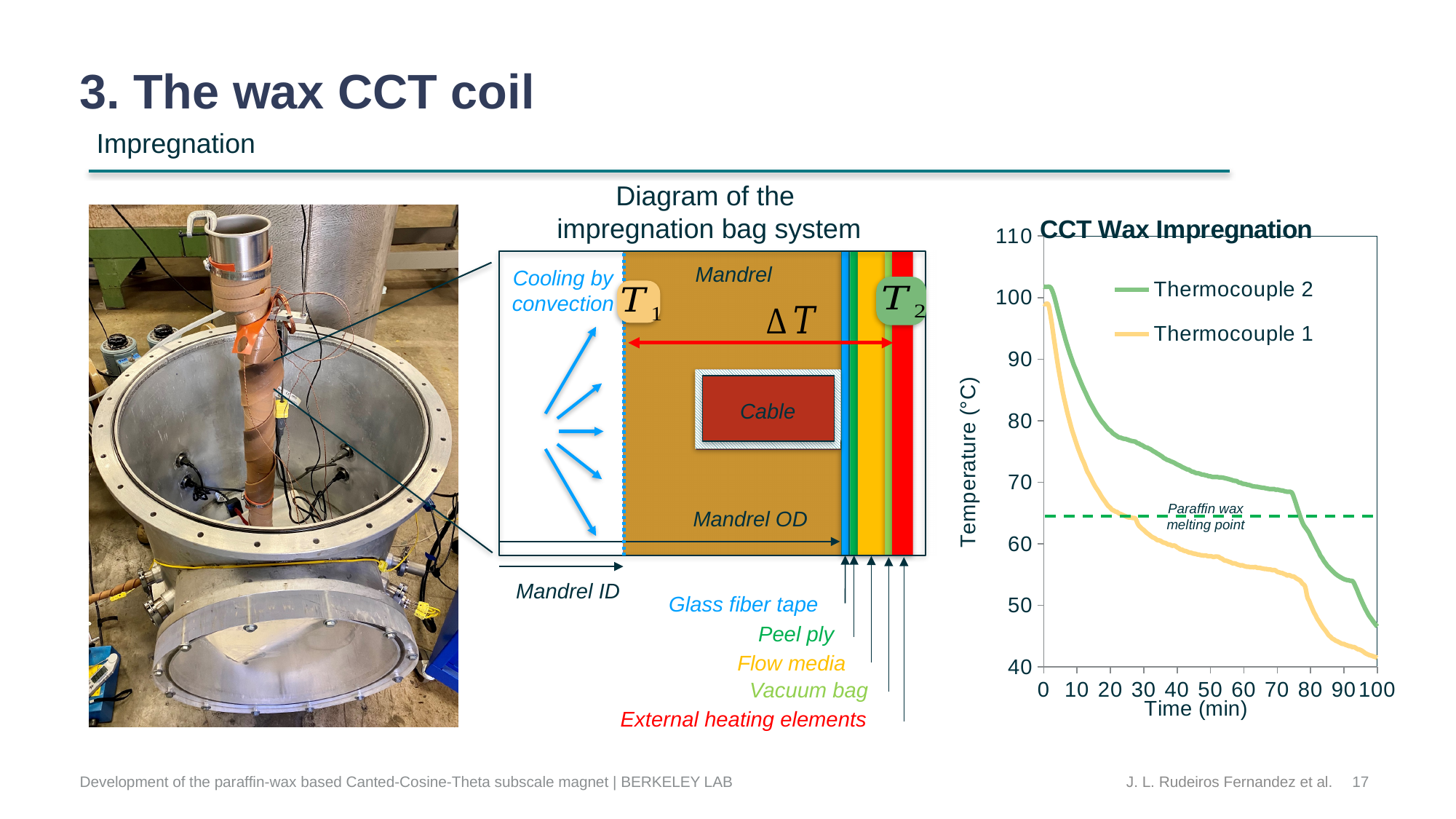
What kind of chart is the "CCT Wax Impregnation" chart? line chart In the "CCT Wax Impregnation" chart, does the temperature for Thermocouple 2 rise or fall as time increases? fall In the "CCT Wax Impregnation" chart, is the value for Thermocouple 2 at 20 min greater or less than 70? greater In the "CCT Wax Impregnation" chart, is the value for Thermocouple 1 at 50 min greater or less than 60? less In the "CCT Wax Impregnation" chart, which series has the higher temperature at 50 min, Thermocouple 1 or Thermocouple 2? Thermocouple 2 What is the label of the y axis of the "CCT Wax Impregnation" chart? Temperature (°C) In the "CCT Wax Impregnation" chart, does the temperature for Thermocouple 1 rise or fall over time? fall What does the dashed horizontal line in the "CCT Wax Impregnation" chart represent? Paraffin wax melting point In the "CCT Wax Impregnation" chart, is the value for Thermocouple 1 at 20 min greater or less than 60? greater In the "CCT Wax Impregnation" chart, which series has the lower temperature at 100 min? Thermocouple 1 How many series does the legend of the "CCT Wax Impregnation" chart list? 2